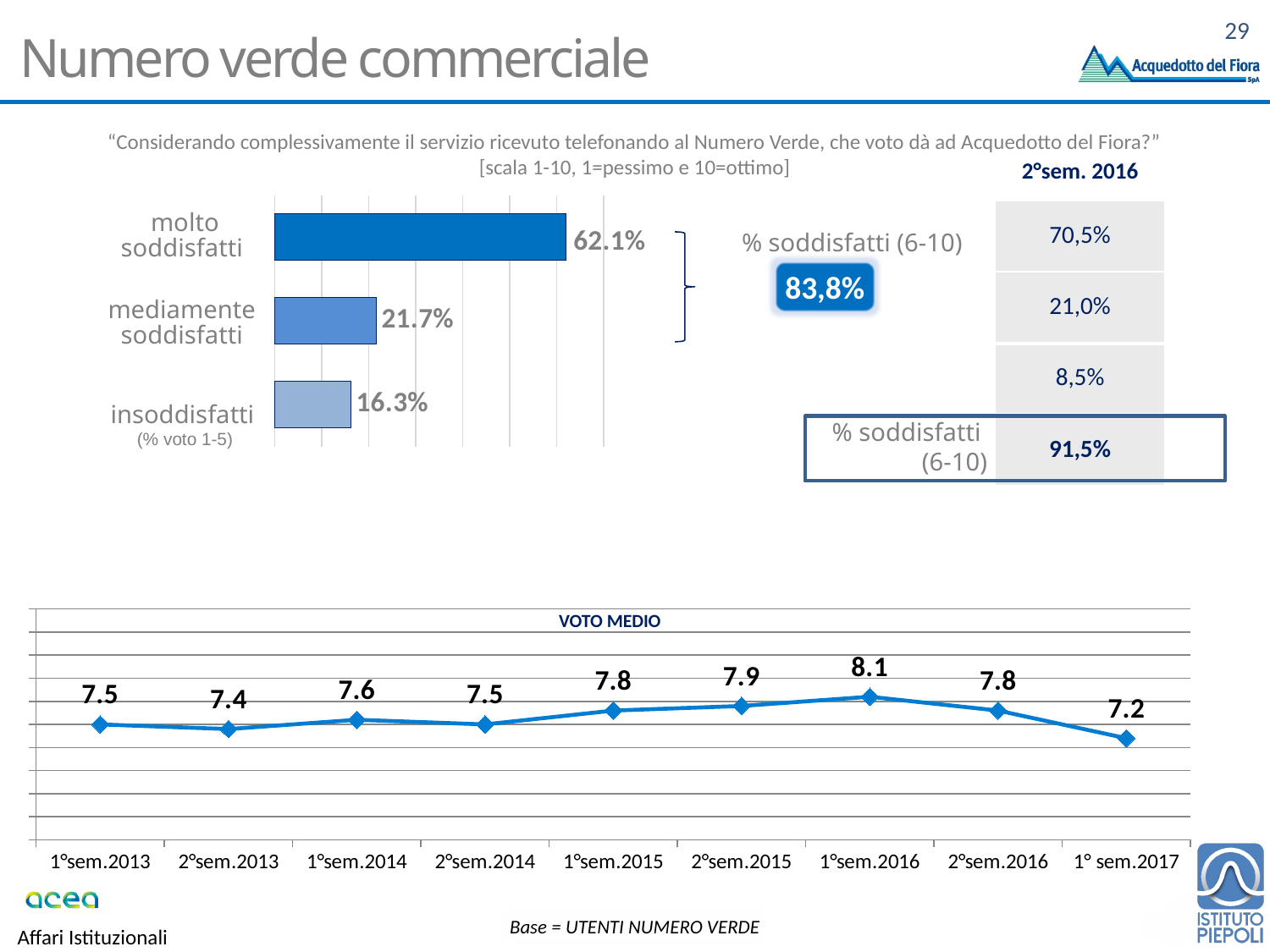
In the VOTO MEDIO chart, how many data points are plotted? 9 In the top bar chart, what is the value for "molto soddisfatti"? 62.1% In the VOTO MEDIO chart, which period has the highest value? 1°sem.2016 In the top bar chart, how many categories are shown? 3 In the VOTO MEDIO chart, what is the value for 1° sem.2017? 7.2 In the top bar chart, what is the difference between "molto soddisfatti" and "mediamente soddisfatti"? 40.4% In the top bar chart, what is the value for "insoddisfatti"? 16.3% In the top bar chart, which category has the lowest value? insoddisfatti What kind of chart is the top chart on the slide? bar chart In the VOTO MEDIO chart, do the values rise or fall from 1°sem.2016 to 1° sem.2017? fall In the VOTO MEDIO chart, what is the value for 1°sem.2016? 8.1 In the VOTO MEDIO chart, which is larger: the value for 2°sem.2015 or the value for 2°sem.2016? 2°sem.2015